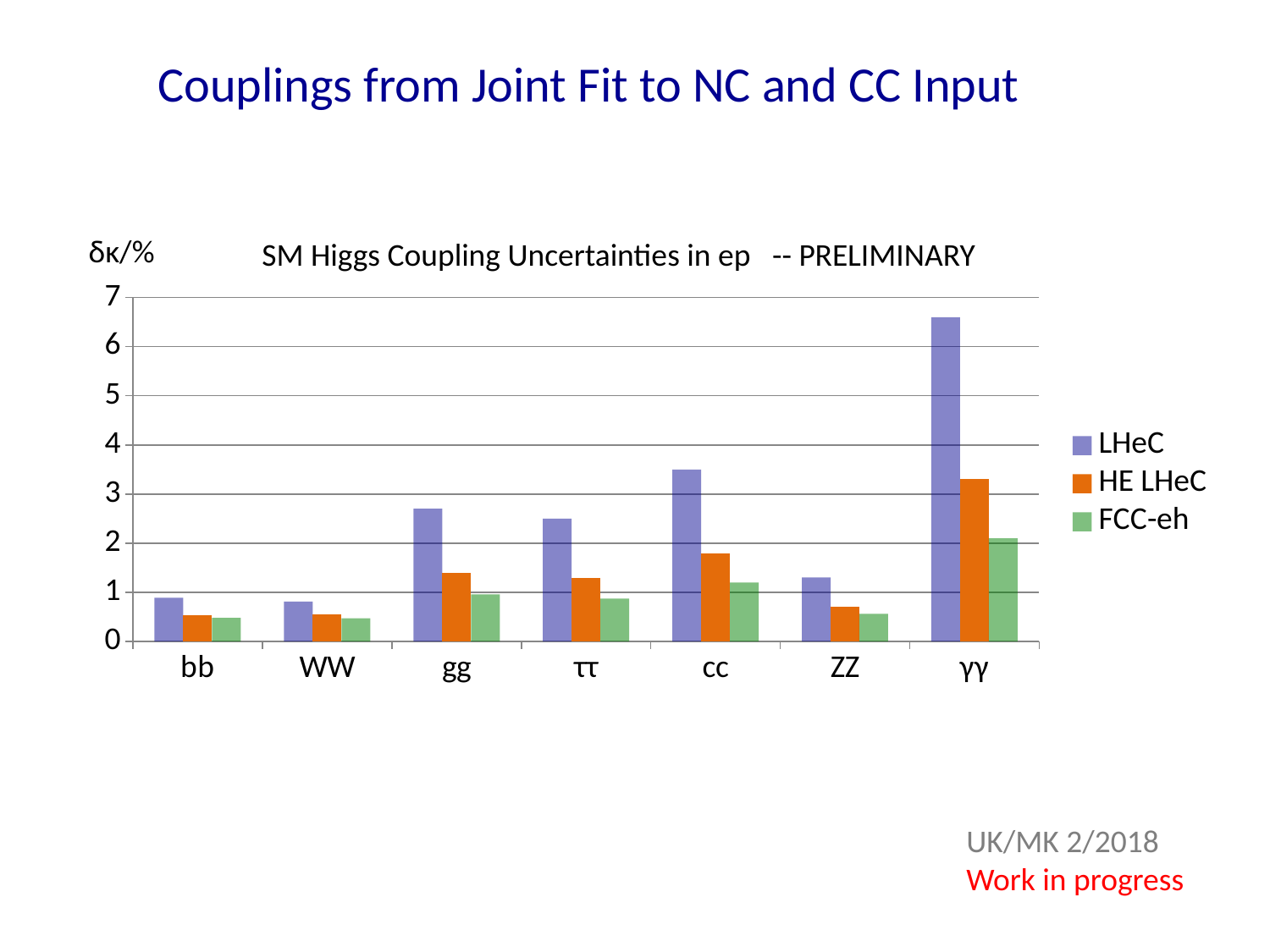
Which is larger for cc: the LHeC value or the FCC-eh value? LHeC For which category is the LHeC value highest? γγ What is the title of the chart? SM Higgs Coupling Uncertainties in ep -- PRELIMINARY Is the LHeC value for cc greater or less than 3? greater How many categories are shown on the x axis? 7 What kind of chart is shown on the slide? bar chart Which is larger for HE LHeC: the value for gg or the value for cc? cc Is the LHeC value for γγ greater or less than 6? greater How many series does the legend list? 3 Is the FCC-eh value for bb greater or less than 1? less For which category is the FCC-eh value highest? γγ